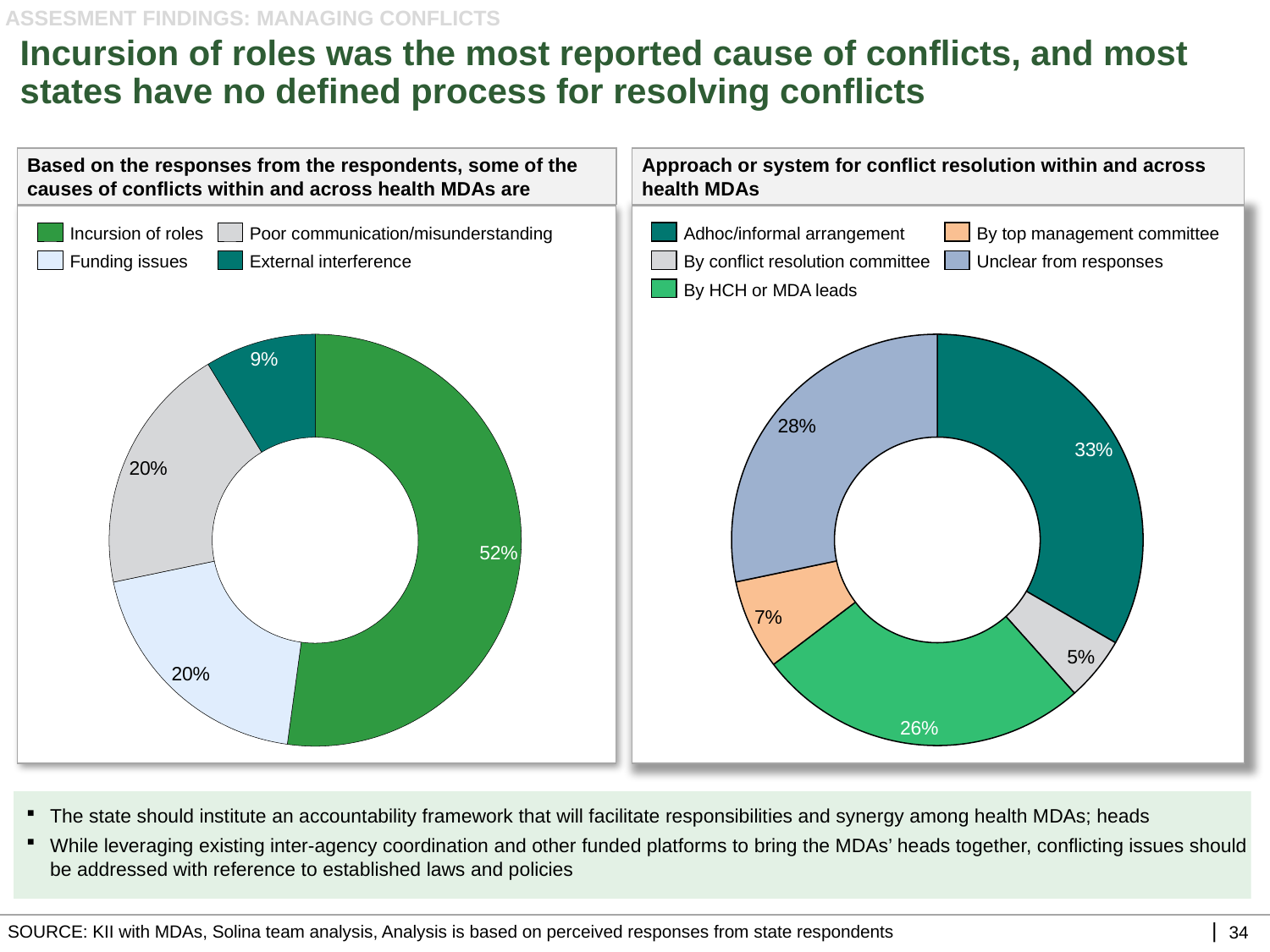
In the right chart, which approach has the smallest share? By conflict resolution committee In the left chart, what share of responses is attributed to Incursion of roles? 52% In the right chart, what percentage is shown for By HCH or MDA leads? 26% In the left chart, what is the difference in percentage points between Incursion of roles and Funding issues? 32 In the left chart, how many slices does the donut have? 4 In the right chart, which approach has the largest share? Adhoc/informal arrangement In the right chart, what percentage is shown for Adhoc/informal arrangement? 33% In the right chart, which is larger: Unclear from responses or By top management committee? Unclear from responses In the left chart, what percentage is shown for External interference? 9% In the left chart, which cause of conflict has the smallest share? External interference How many entries does the legend of the right chart list? 5 What type of chart is used on the left side of the slide? Pie (donut) chart